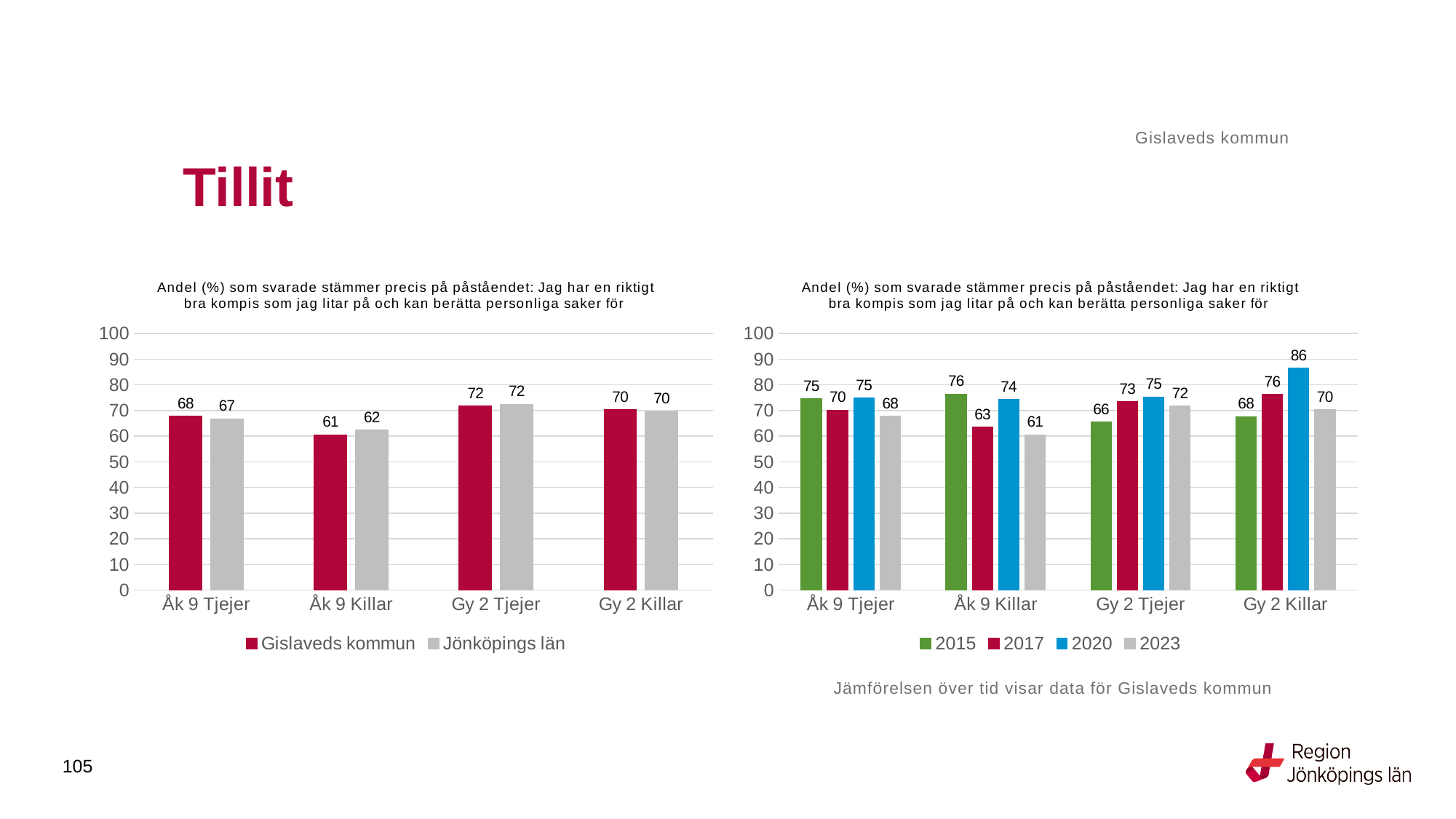
What kind of chart is the left chart? Bar chart In the right chart, which year has the highest value for Gy 2 Killar? 2020 In the left chart, what is the value for Gislaveds kommun for Åk 9 Tjejer? 68 In the right chart, what is the value for 2017 for Åk 9 Killar? 63 In the left chart, what is the difference between Gislaveds kommun and Jönköpings län for Åk 9 Tjejer? 1 In the right chart, how many series does the legend list? 4 In the left chart, what is the value for Jönköpings län for Åk 9 Killar? 62 In the right chart, what is the value for 2020 for Gy 2 Killar? 86 In the right chart, which is larger for Åk 9 Tjejer: the 2015 value or the 2023 value? 2015 In the left chart, which category has the lowest value for Gislaveds kommun? Åk 9 Killar In the left chart, how many series does the legend list? 2 In the right chart, what is the difference between the 2020 and 2023 values for Gy 2 Killar? 16